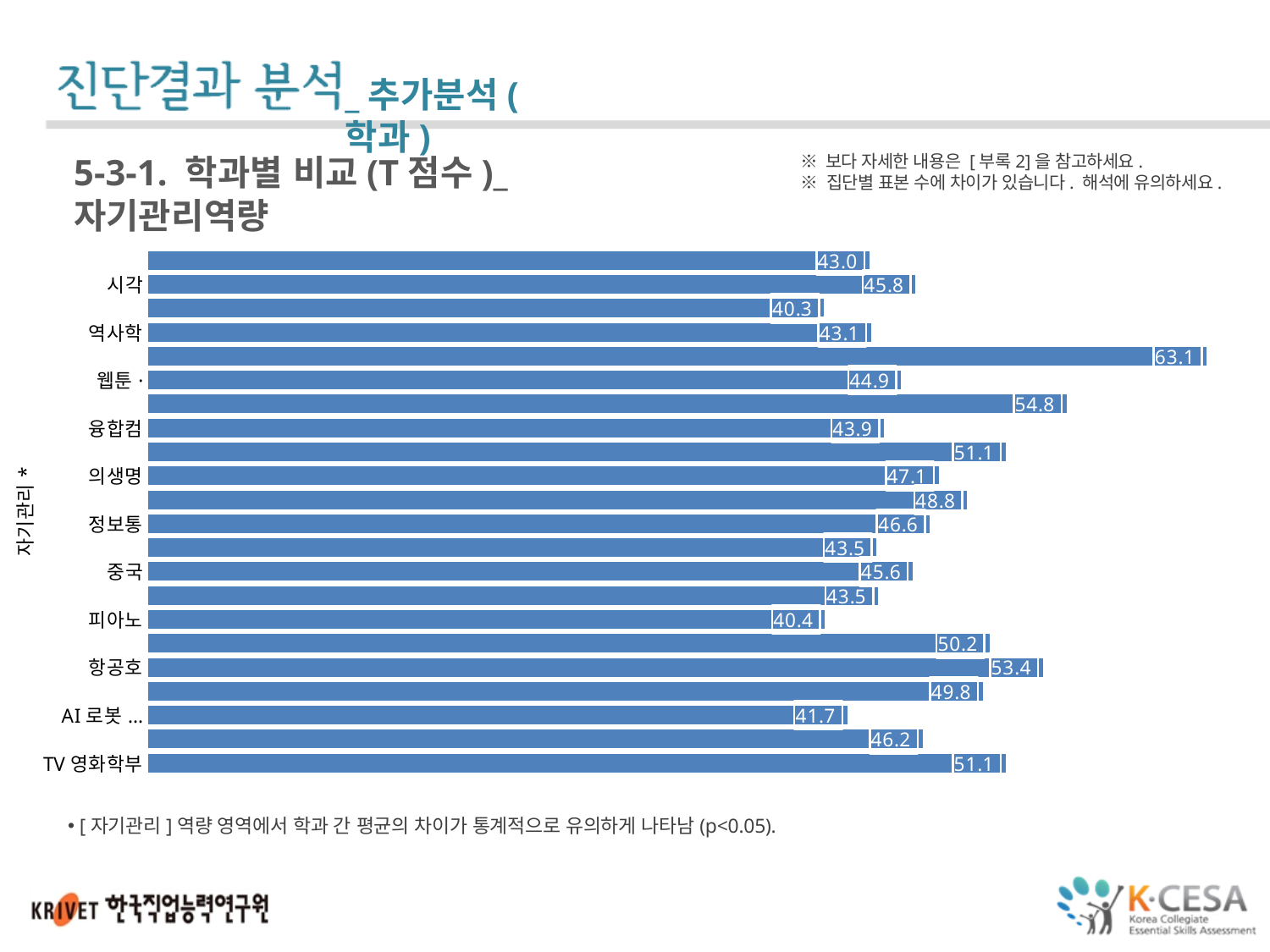
What is the highest value shown on the chart? 63.1 What is the value for 항공호? 53.4 How many bars are plotted on the chart? 22 What kind of chart is shown on the slide? Bar chart Which has a larger value, 항공호 or 중국? 항공호 What is the difference between the values for 항공호 and 피아노? 13.0 What is the value for 피아노? 40.4 What is the value for 시각? 45.8 What is the value for 역사학? 43.1 What is the value for 의생명? 47.1 What is the value for TV 영화학부? 51.1 What is the lowest value shown on the chart? 40.3